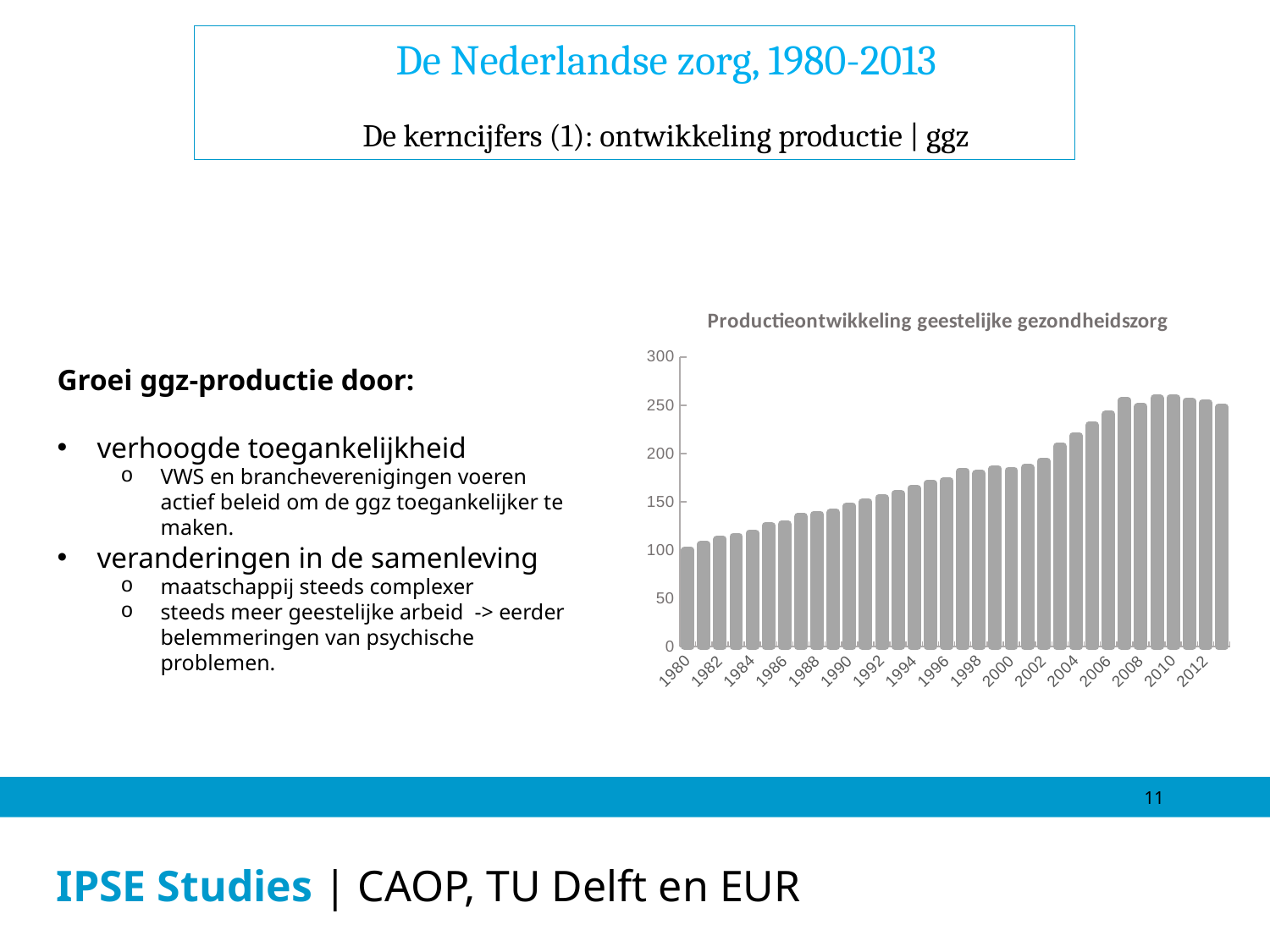
What kind of chart is shown on the slide? bar chart How many years (bars) are plotted in the chart? 34 Is the value for 2010 greater or less than 250? greater What is the value for 1980 in the chart? 100 Which is larger, the value for 2004 or the value for 2000? 2004 Is the value for 2000 greater or less than 200? less Is the value for 2004 greater or less than 200? greater Which year has the lowest value in the chart? 1980 Which is larger, the value for 2010 or the value for 1980? 2010 Do the values generally rise or fall from 1980 to 2010? rise What is the title of the chart? Productieontwikkeling geestelijke gezondheidszorg